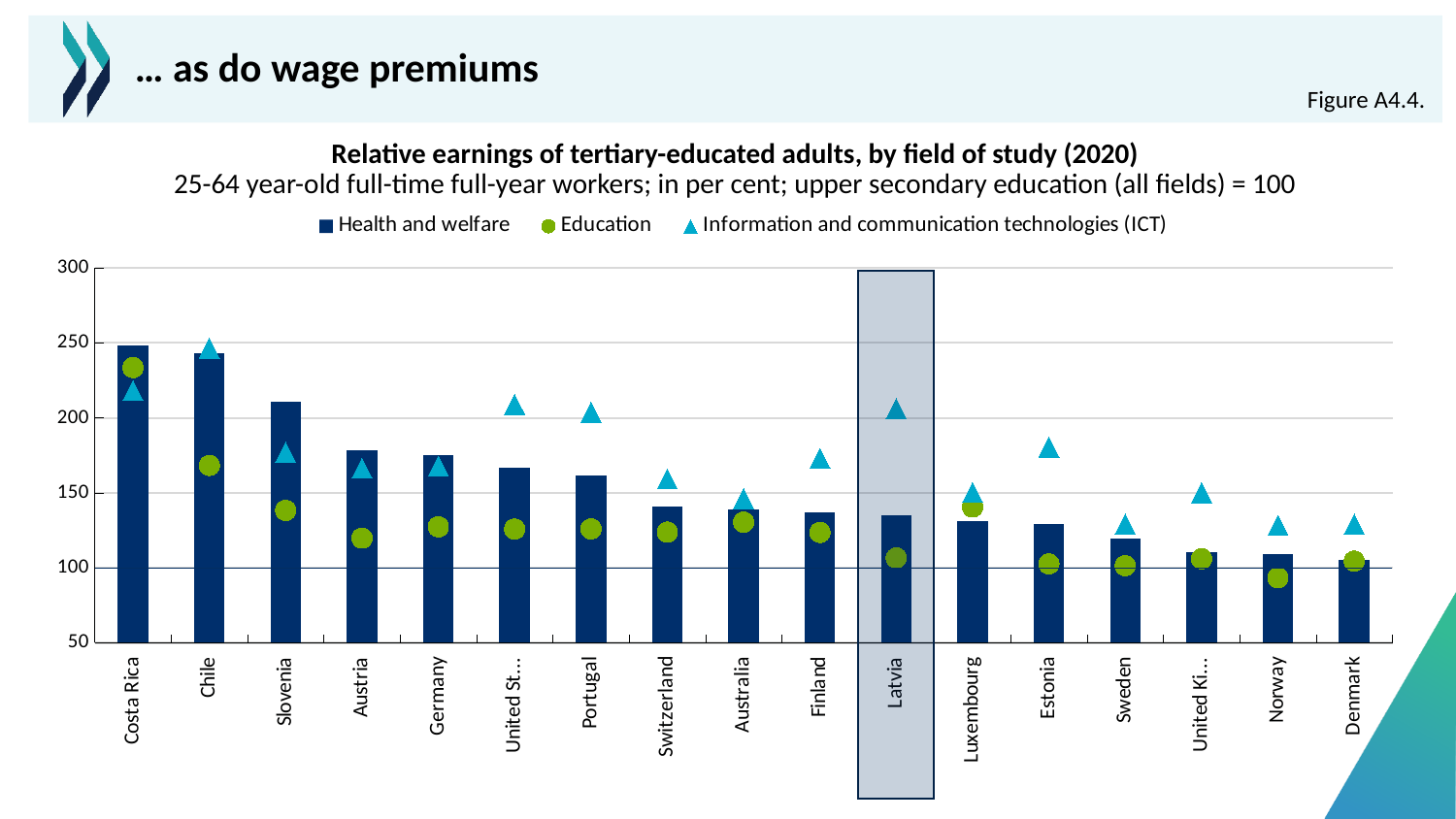
Is the Health and welfare value for Costa Rica greater or less than 200? greater Do the Health and welfare bars generally rise or fall from left to right across the countries? fall How many countries are shown on the x axis of the chart? 17 For Chile, which is larger: the Education value or the ICT value? ICT What kind of chart is shown on the slide? Bar chart with point markers Is the Education value for Norway greater or less than 100? less Is the ICT value for Chile greater or less than 200? greater For Latvia, which is larger: the ICT value or the Health and welfare value? ICT How many series does the chart's legend list? 3 Which country is highlighted with a shaded box on the chart? Latvia